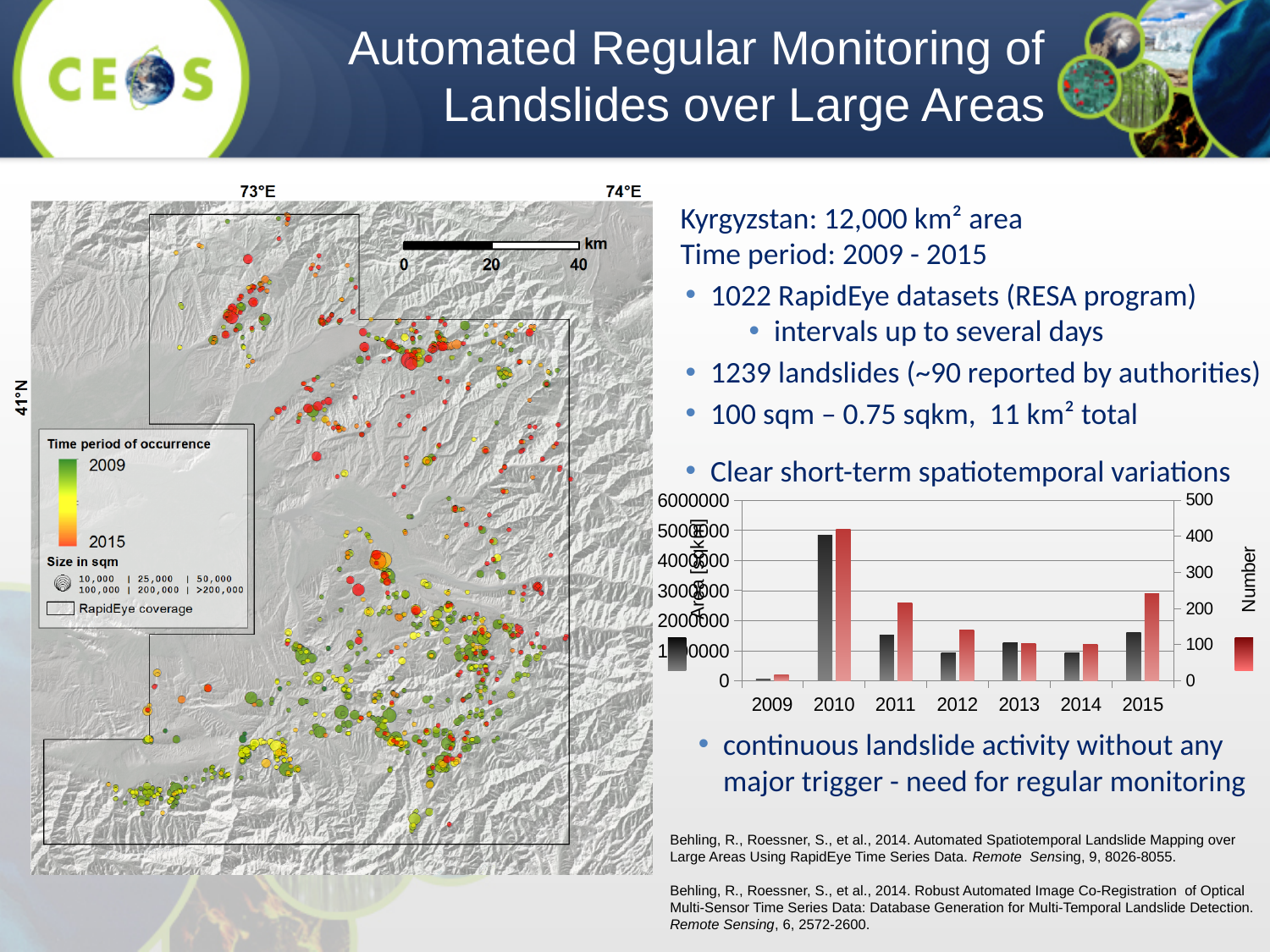
Which year has the larger red (Number) bar, 2011 or 2012? 2011 What kind of chart is shown on the slide? bar chart Is the dark grey (Area) bar for 2009 greater or less than 1000000? less What is the title of the right-hand vertical axis of the bar chart? Number How many years are shown on the x axis of the bar chart? 7 Which year has the tallest bars in the bar chart? 2010 Is the red (Number) bar for 2012 greater or less than 100? greater Which year has the larger dark grey (Area) bar, 2011 or 2014? 2011 Is the red (Number) bar for 2015 greater or less than 200? greater Which year has the shortest bars in the bar chart? 2009 How many data series does the bar chart plot? 2